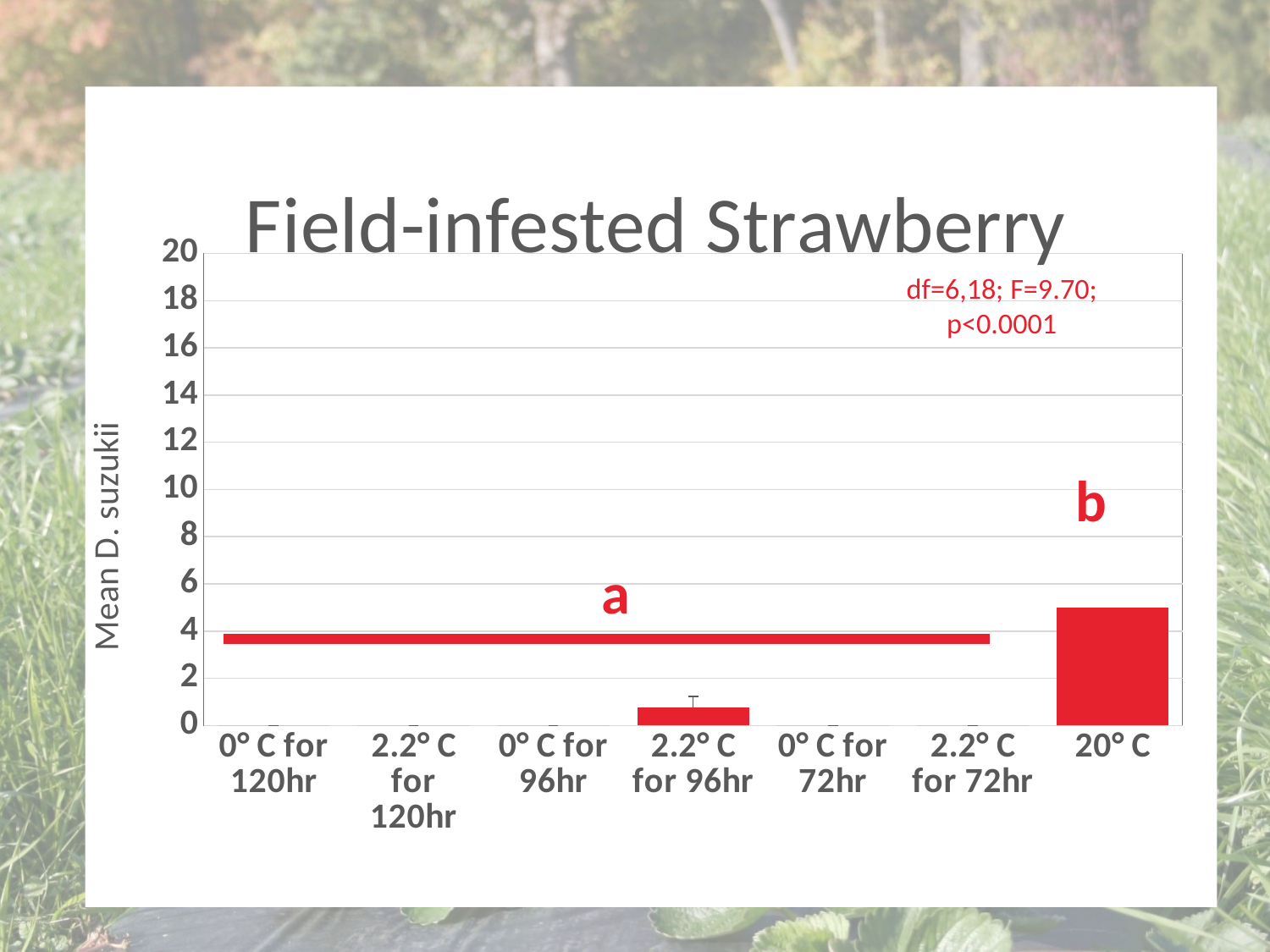
Is the value for 20° C greater or less than 10? less Is the value for 20° C greater or less than 4? greater What is the title of the chart? Field-infested Strawberry What is the highest value shown on the y axis of the chart? 20 Is the value for 20° C greater or less than 6? less Which category has the highest mean D. suzukii value? 20° C What is the label on the y axis of the chart? Mean D. suzukii How many categories are shown on the x axis of the chart? 7 Which is larger, the value for 20° C or the value for 2.2° C for 96hr? 20° C What kind of chart is shown on the slide? bar chart